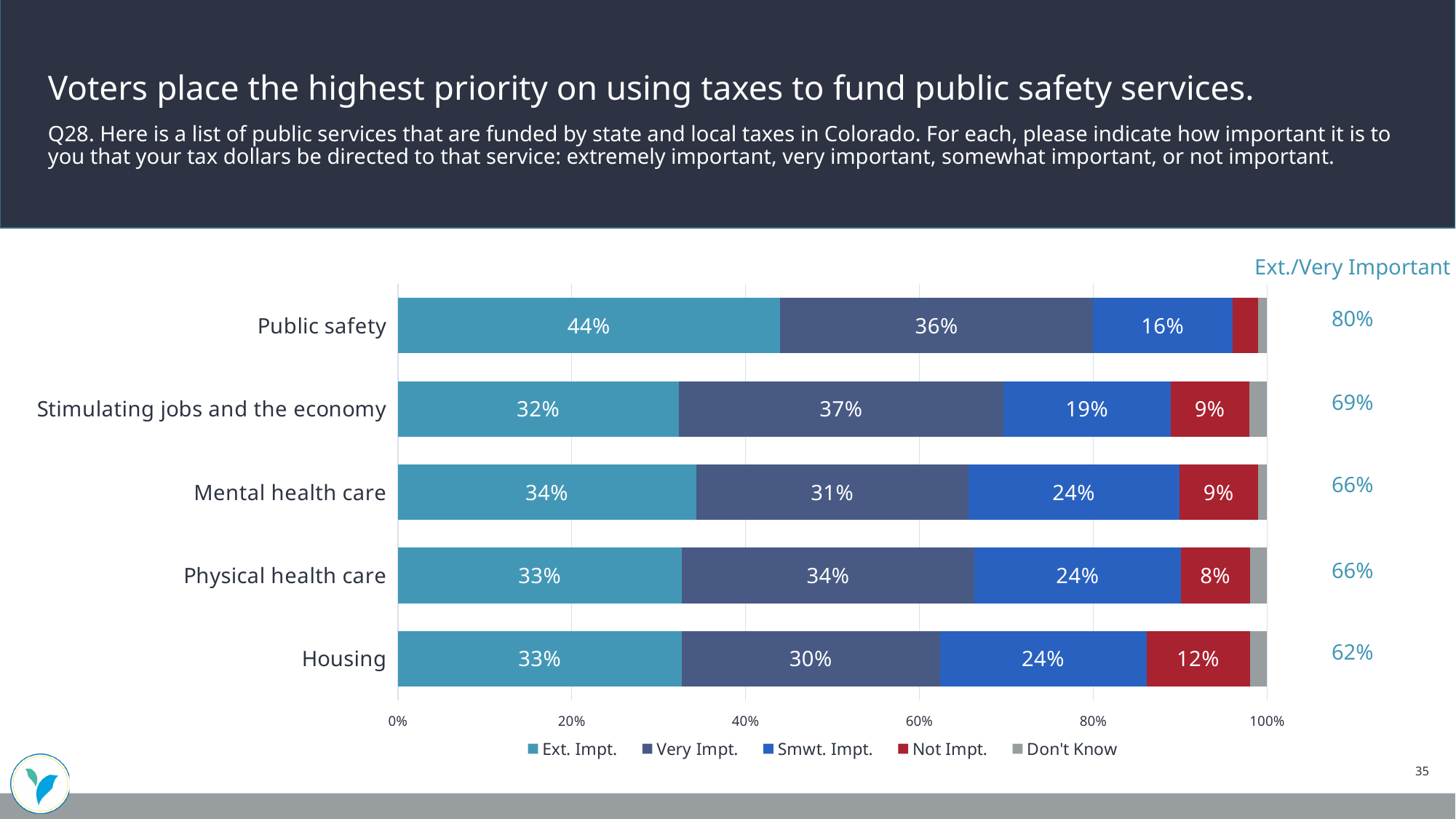
Which service has the highest Not Impt. percentage? Housing What is the Not Impt. value for Housing? 12% Which has a larger Smwt. Impt. value, Public safety or Mental health care? Mental health care Which service has the lowest Ext. Impt. percentage? Stimulating jobs and the economy What kind of chart is shown on the slide? Stacked bar chart How many series does the legend list? 5 What percentage of voters rated public safety as extremely important (Ext. Impt.)? 44% Which service has the highest Ext. Impt. percentage? Public safety What is the Smwt. Impt. value for Stimulating jobs and the economy? 19% What is the Ext./Very Important figure shown for Housing? 62% How many public services are listed in the chart? 5 How many percentage points higher is the Ext. Impt. value for Public safety than for Housing? 11 percentage points